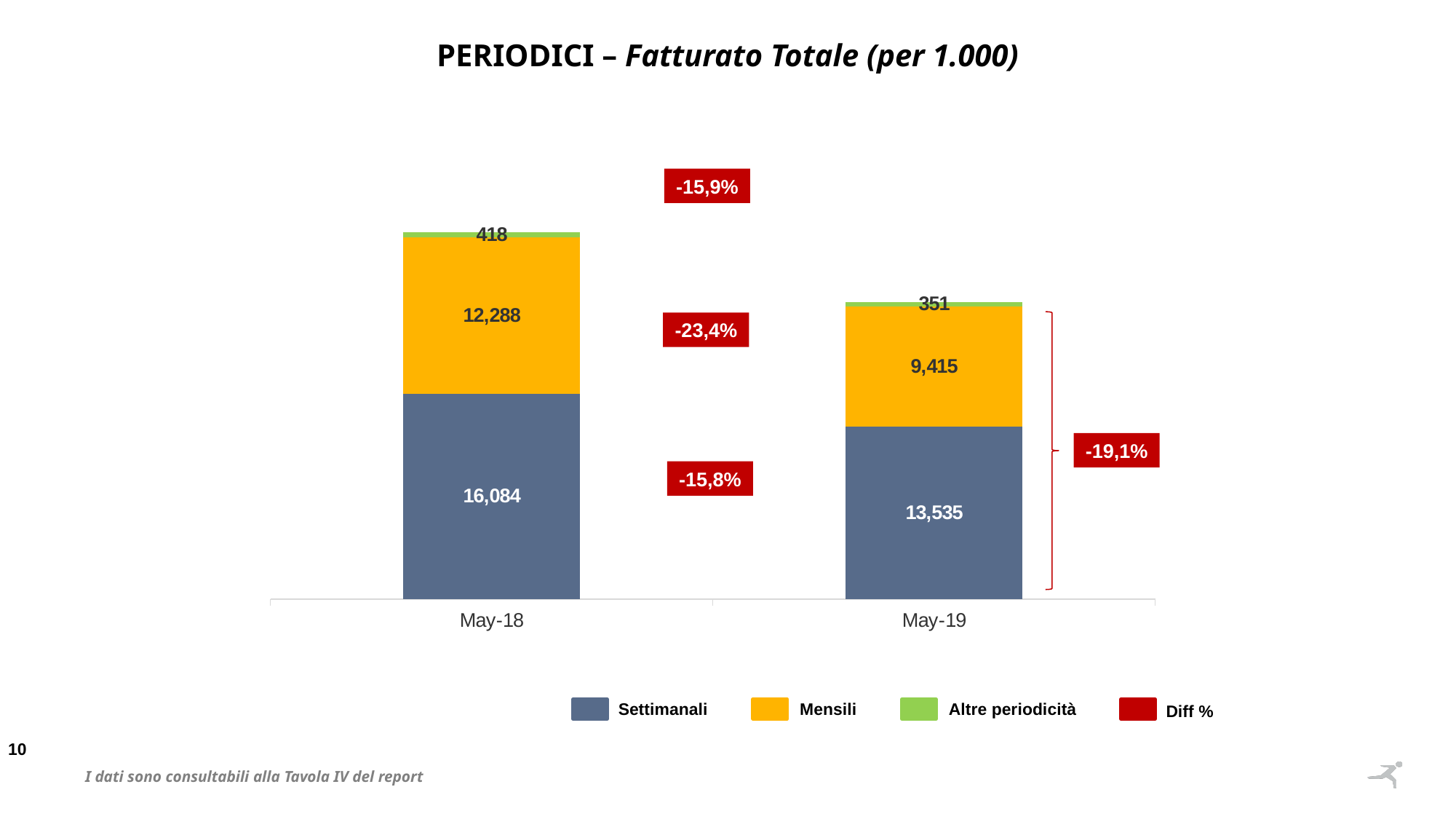
What is the difference between the Settimanali values for May-18 and May-19? 2,549 What is the total of the stacked bar for May-18? 28,790 What is the Altre periodicità value for May-18? 418 What is the total of the stacked bar for May-19? 23,301 What is the Settimanali value for May-18? 16,084 What is the Mensili value for May-19? 9,415 What is the percentage difference shown for the total between May-18 and May-19? -19,1% What is the Settimanali value for May-19? 13,535 What kind of chart is shown on the slide? Stacked bar chart How many series does the legend list? 4 Which period has the larger Mensili value, May-18 or May-19? May-18 What is the difference between the Mensili values for May-18 and May-19? 2,873